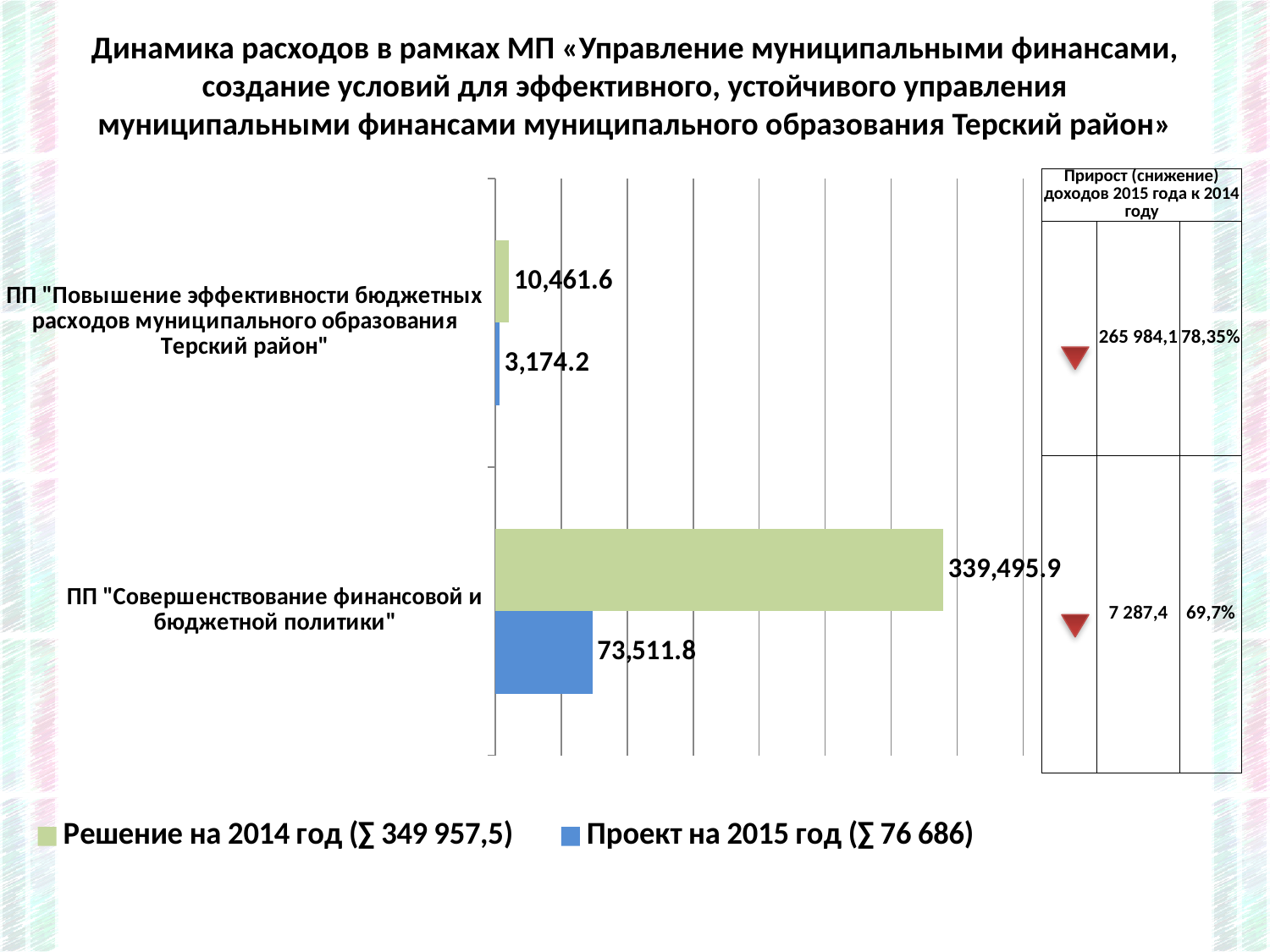
How many series does the legend list? 2 What total is shown in the legend for the series "Проект на 2015 год"? ∑ 76 686 What is the difference between the 2014 and 2015 values for ПП "Совершенствование финансовой и бюджетной политики"? 265,984.1 Which category has the highest value in the "Решение на 2014 год" series? ПП "Совершенствование финансовой и бюджетной политики" Which is larger for ПП "Повышение эффективности бюджетных расходов муниципального образования Терский район": the 2014 value or the 2015 value? the 2014 value Which category has the lowest value in the "Проект на 2015 год" series? ПП "Повышение эффективности бюджетных расходов муниципального образования Терский район" What is the value of "Решение на 2014 год" for ПП "Совершенствование финансовой и бюджетной политики"? 339,495.9 How many categories are plotted on the chart? 2 What is the value of "Проект на 2015 год" for ПП "Повышение эффективности бюджетных расходов муниципального образования Терский район"? 3,174.2 What is the value of "Проект на 2015 год" for ПП "Совершенствование финансовой и бюджетной политики"? 73,511.8 What is the value of "Решение на 2014 год" for ПП "Повышение эффективности бюджетных расходов муниципального образования Терский район"? 10,461.6 What type of chart is shown on the slide? bar chart